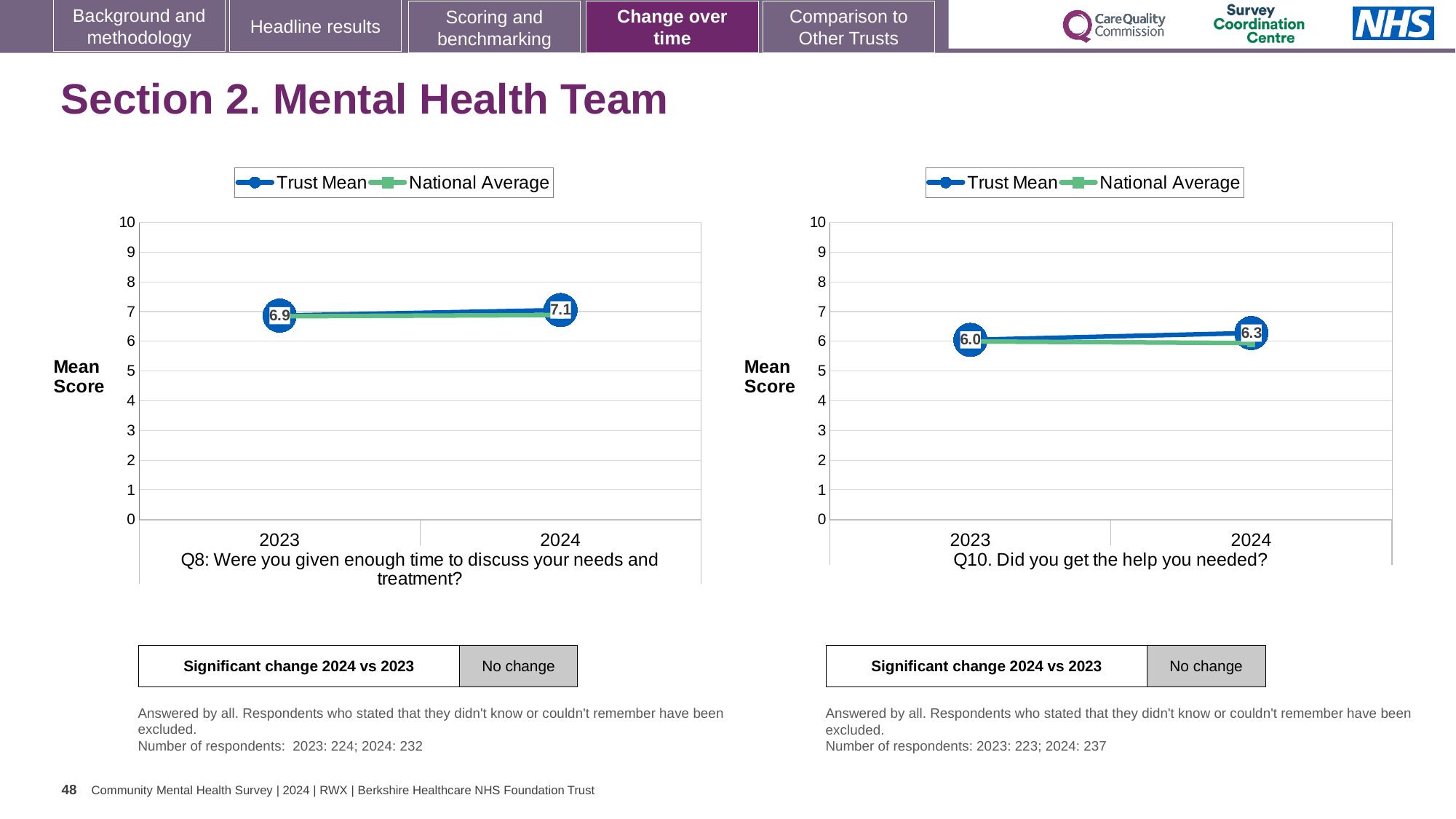
In the Q10 chart (right), what is the Trust Mean score for 2024? 6.3 In the Q8 chart (left), what is the Trust Mean score for 2023? 6.9 In the Q8 chart (left), is the Trust Mean for 2024 greater or less than 6? greater In the Q10 chart (right), does the Trust Mean rise or fall from 2023 to 2024? rise How many years are plotted on the x axis of the Q8 chart (left)? 2 In the Q10 chart (right), what is the Trust Mean score for 2023? 6.0 What type of chart is the Q10 chart (right)? line chart How many series does the legend of the Q8 chart (left) list? 2 In the Q10 chart (right), is the Trust Mean for 2023 greater or less than 7? less In the Q8 chart (left), what is the Trust Mean score for 2024? 7.1 In the Q10 chart (right), by how much did the Trust Mean change from 2023 to 2024? 0.3 In the Q8 chart (left), by how much did the Trust Mean change from 2023 to 2024? 0.2